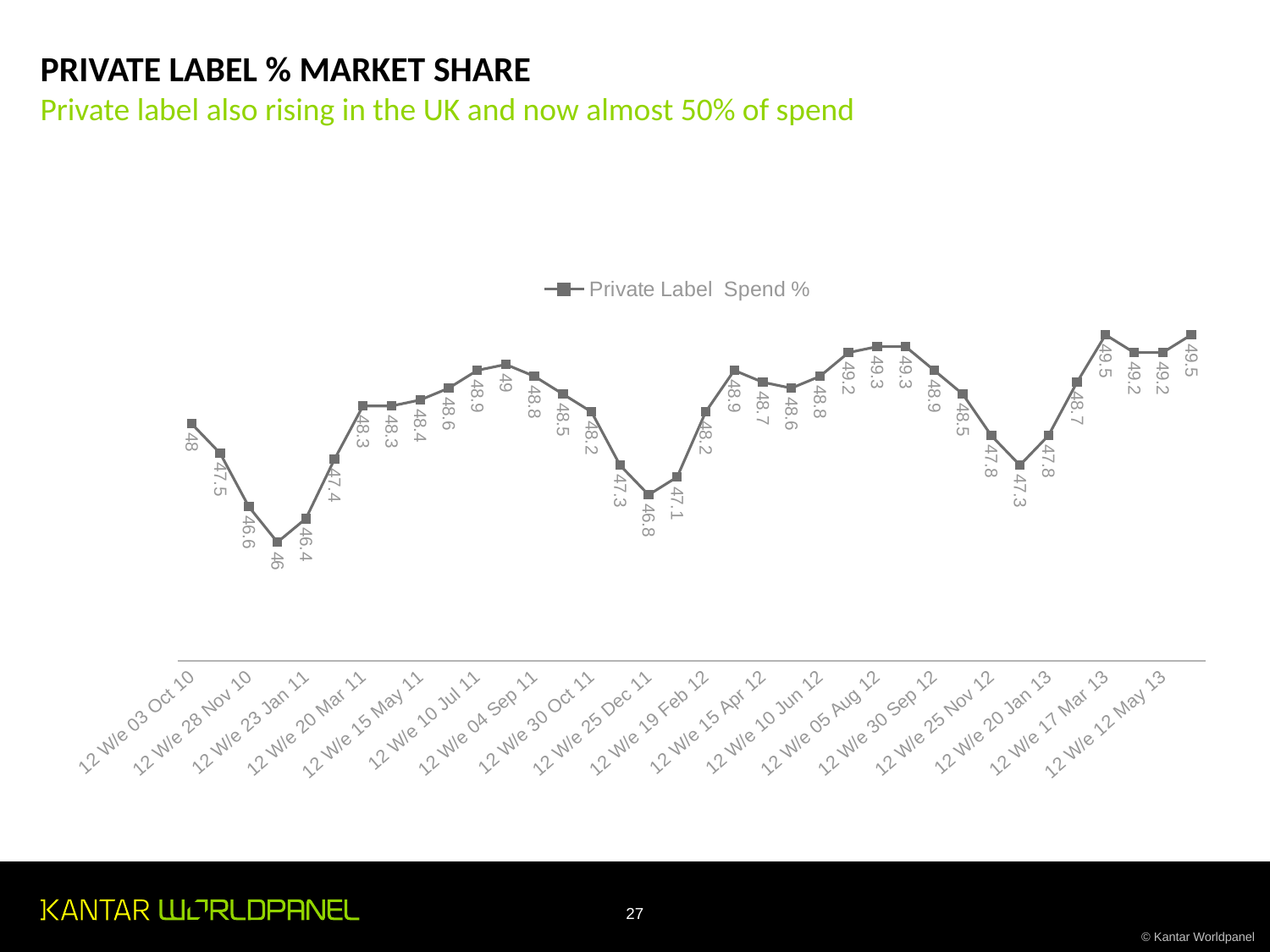
What is the title of the slide's chart section? PRIVATE LABEL % MARKET SHARE Overall, does the Private Label Spend % rise or fall from the first point to the last point? rise Is the first data point (48) larger or smaller than the last data point (49.5)? smaller What is the difference between the highest and lowest values plotted on the line? 3.5 What is the highest value plotted on the line? 49.5 How many series does the legend list? 1 What is the value of the last data point on the line? 49.5 What kind of chart is shown on the slide? line chart What is the difference between the last data point and the first data point on the line? 1.5 What is the value of the first data point on the line (12 W/e 03 Oct 10)? 48 What is the name of the series shown in the legend? Private Label Spend % What is the lowest value plotted on the line? 46